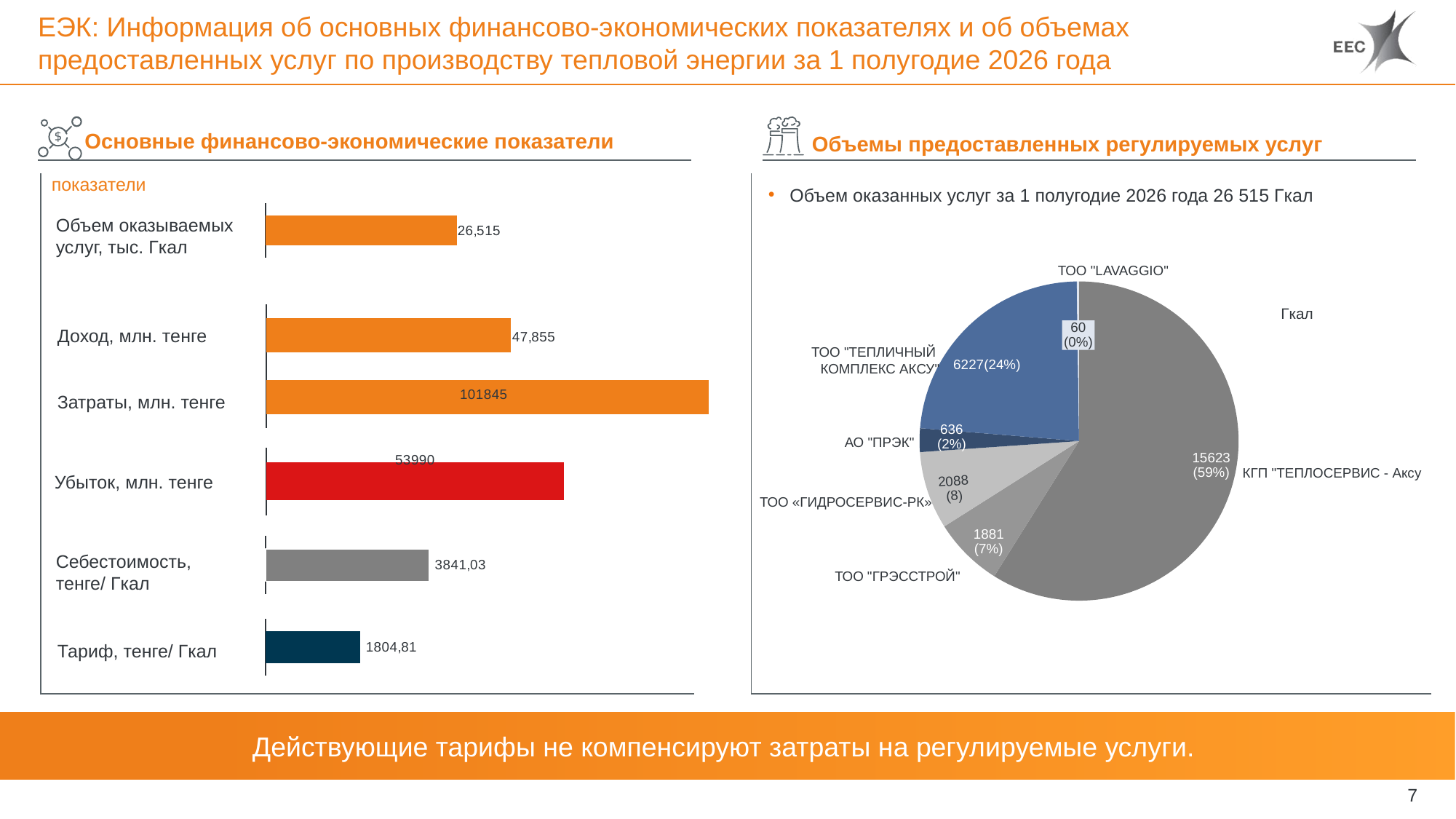
In the bar chart 'Основные финансово-экономические показатели', what is the value for 'Себестоимость, тенге/ Гкал'? 3841,03 In the bar chart 'Основные финансово-экономические показатели', what is the value for 'Доход, млн. тенге'? 47,855 In the pie chart 'Объемы предоставленных регулируемых услуг', what share does ТОО "ТЕПЛИЧНЫЙ КОМПЛЕКС АКСУ" have? 24% What kind of chart is shown under 'Объемы предоставленных регулируемых услуг'? Pie chart In the bar chart 'Основные финансово-экономические показатели', what is the value for 'Тариф, тенге/ Гкал'? 1804,81 In the pie chart 'Объемы предоставленных регулируемых услуг', how many slices are there? 6 In the bar chart 'Основные финансово-экономические показатели', how many indicators are plotted? 6 In the pie chart 'Объемы предоставленных регулируемых услуг', which company has the smallest slice? ТОО "LAVAGGIO" In the bar chart 'Основные финансово-экономические показатели', which bar is shown in red? Убыток, млн. тенге In the bar chart 'Основные финансово-экономические показатели', which indicator has the highest value? Затраты, млн. тенге In the pie chart 'Объемы предоставленных регулируемых услуг', what is the value for КГП "ТЕПЛОСЕРВИС - Аксу"? 15623 In the bar chart 'Основные финансово-экономические показатели', which indicator has the lowest value? Тариф, тенге/ Гкал